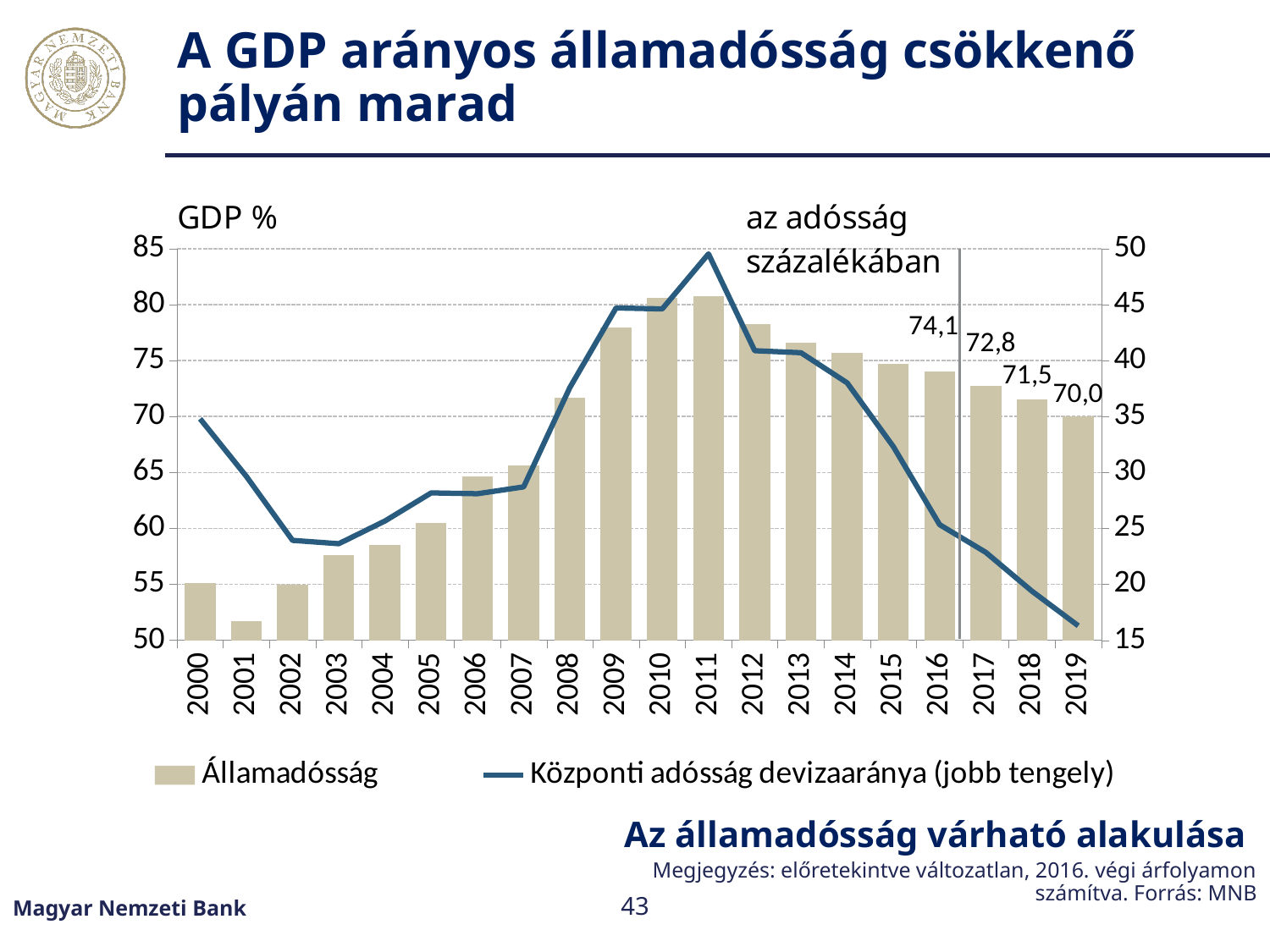
How many years are shown on the x axis? 20 What is the value of the Államadósság bar for 2019? 70,0 What is the difference between the Államadósság values for 2016 and 2019? 4,1 What is the value of the Államadósság bar for 2017? 72,8 Is the Államadósság value for 2003 greater or less than 60? less How many series does the legend list? 2 Is the Államadósság value for 2009 greater or less than 75? greater What is the difference between the Államadósság values for 2017 and 2018? 1,3 In which year does the Központi adósság devizaaránya line reach its highest point? 2011 Which is larger, the Államadósság bar for 2008 or for 2012? 2012 Which year has the lowest Államadósság bar? 2001 What is the value of the Államadósság bar for 2016? 74,1